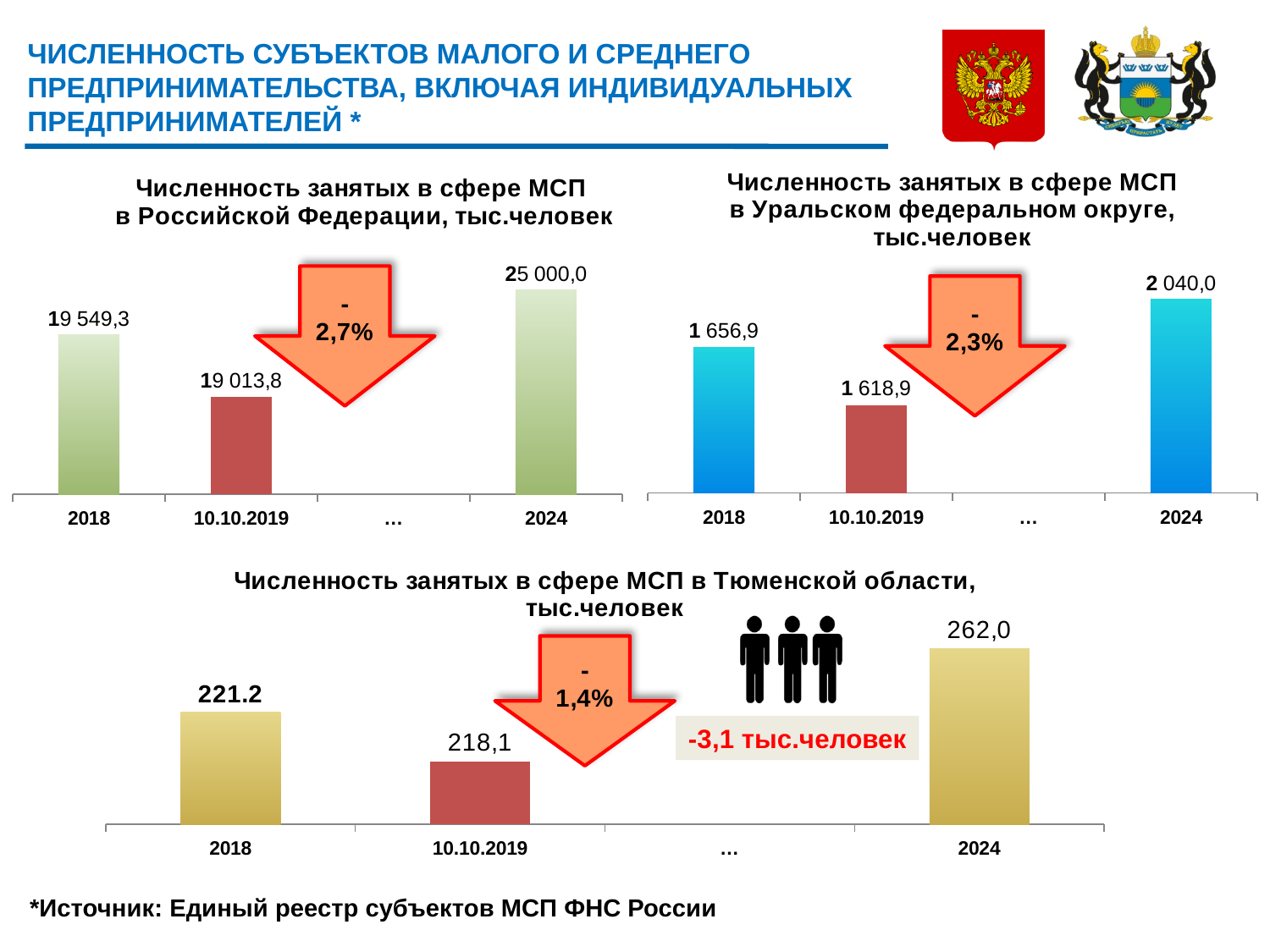
In the chart for the Tyumen region (bottom), what is the value for 10.10.2019? 218,1 What kind of chart is the chart for the Russian Federation (top left)? Bar chart In the chart for the Russian Federation (top left), what is the difference between the 2018 value and the 10.10.2019 value? 535,5 In the chart for the Ural Federal District (top right), what is the value for 2024? 2 040,0 In the chart for the Tyumen region (bottom), which is larger, the value for 2018 or the value for 2024? 2024 In the chart for the Russian Federation (top left), what is the value for 10.10.2019? 19 013,8 In the chart for the Ural Federal District (top right), what is the difference between the 2018 value and the 10.10.2019 value? 38,0 How many bars are plotted in the chart for the Tyumen region (bottom)? 3 In the chart for the Ural Federal District (top right), which category has the lowest value? 10.10.2019 In the chart for the Russian Federation (top left), which category has the highest value? 2024 In the chart for the Russian Federation (top left), what is the value for 2018? 19 549,3 In the chart for the Tyumen region (bottom), what is the difference between the 2024 value and the 10.10.2019 value? 43,9